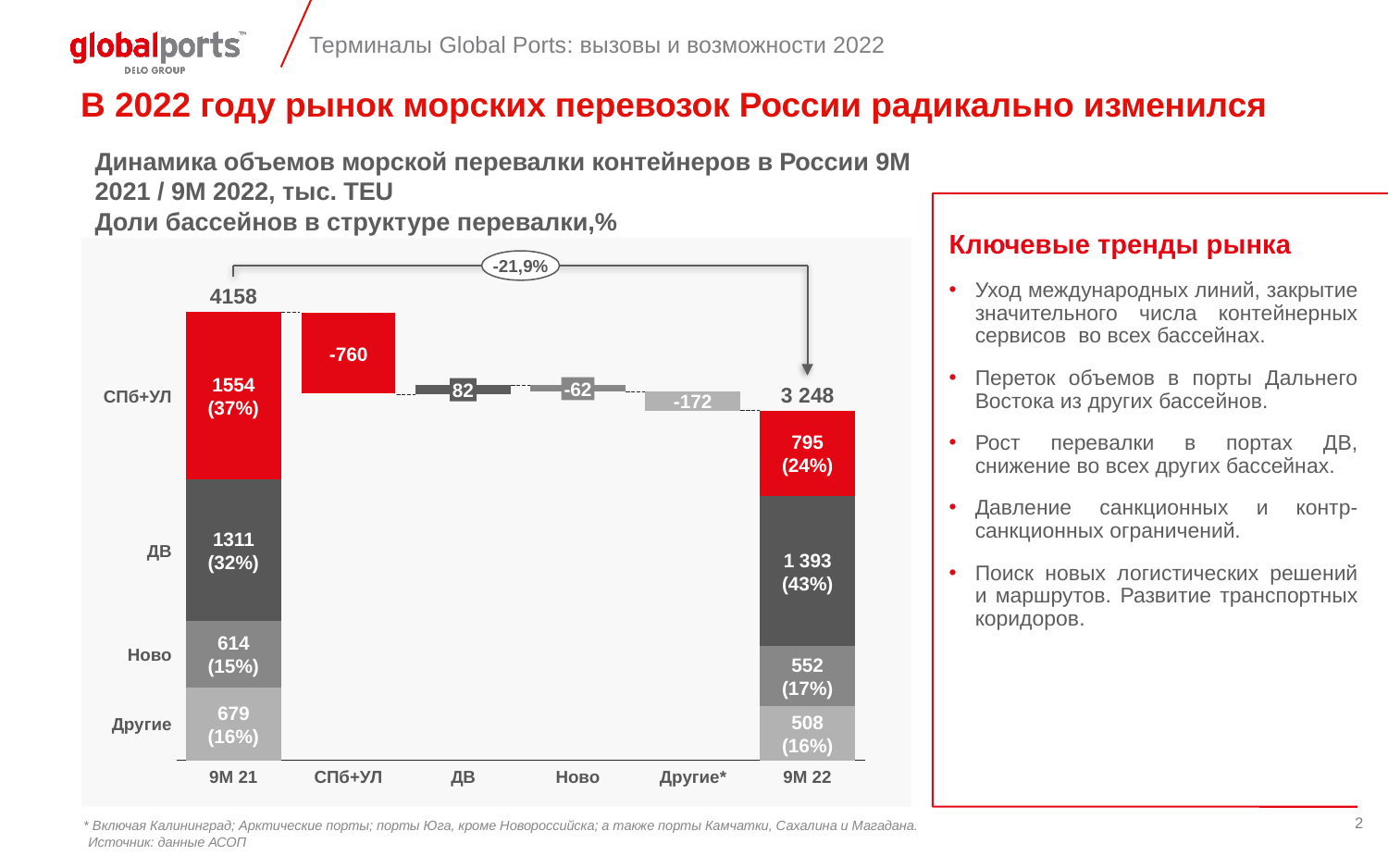
Which basin has the largest segment in the 9M 22 bar? ДВ What is the overall percentage change from 9M 21 to 9M 22 shown at the top of the chart? -21,9% What change is shown for ДВ between 9M 21 and 9M 22? 82 Which basin has the smallest segment in the 9M 21 bar? Ново What share of the 9M 22 total does ДВ account for? 43% What is the total container throughput shown for 9M 21? 4158 What change is shown for СПб+УЛ between 9M 21 and 9M 22? -760 What is the value for ДВ in the 9M 22 bar? 1 393 What is the value for СПб+УЛ in the 9M 21 bar? 1554 What is the difference between the Ново values in 9M 21 and 9M 22? 62 What is the total container throughput shown for 9M 22? 3 248 Which is larger: the СПб+УЛ segment in 9M 21 or the ДВ segment in 9M 21? СПб+УЛ